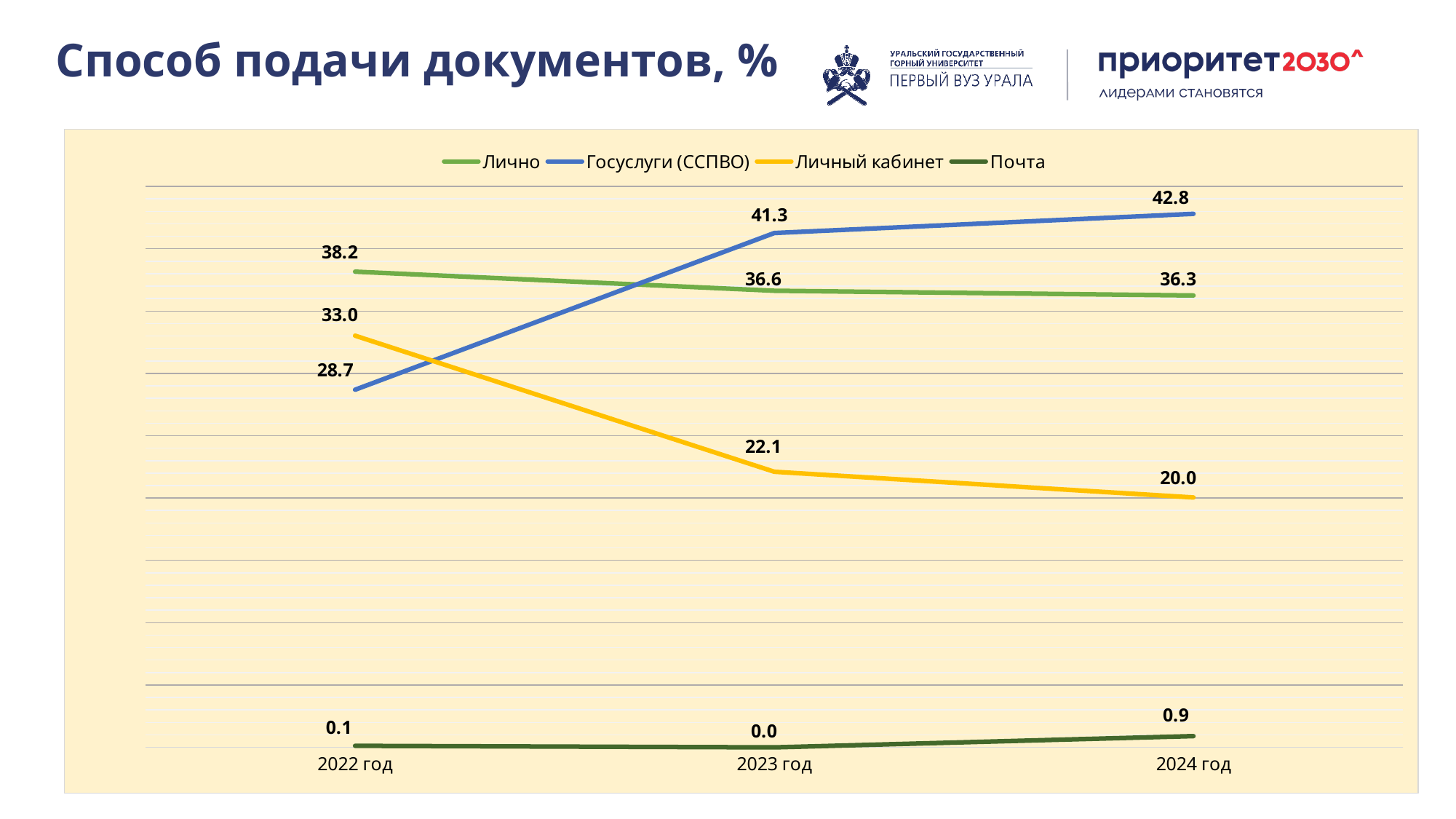
Which series has the highest value in 2024 год? Госуслуги (ССПВО) Does the Личный кабинет series rise or fall from 2022 год to 2024 год? fall What is the value for Лично in 2022 год? 38.2 What is the difference between the Госуслуги (ССПВО) values in 2024 год and 2022 год? 14.1 Which is larger in 2022 год: Лично or Личный кабинет? Лично What is the value for Почта in 2023 год? 0.0 Which series has the lowest value in 2022 год? Почта What is the value for Личный кабинет in 2024 год? 20.0 How many series does the legend list? 4 How many years are shown on the x axis? 3 What type of chart is shown on the slide? line chart What is the value for Госуслуги (ССПВО) in 2023 год? 41.3